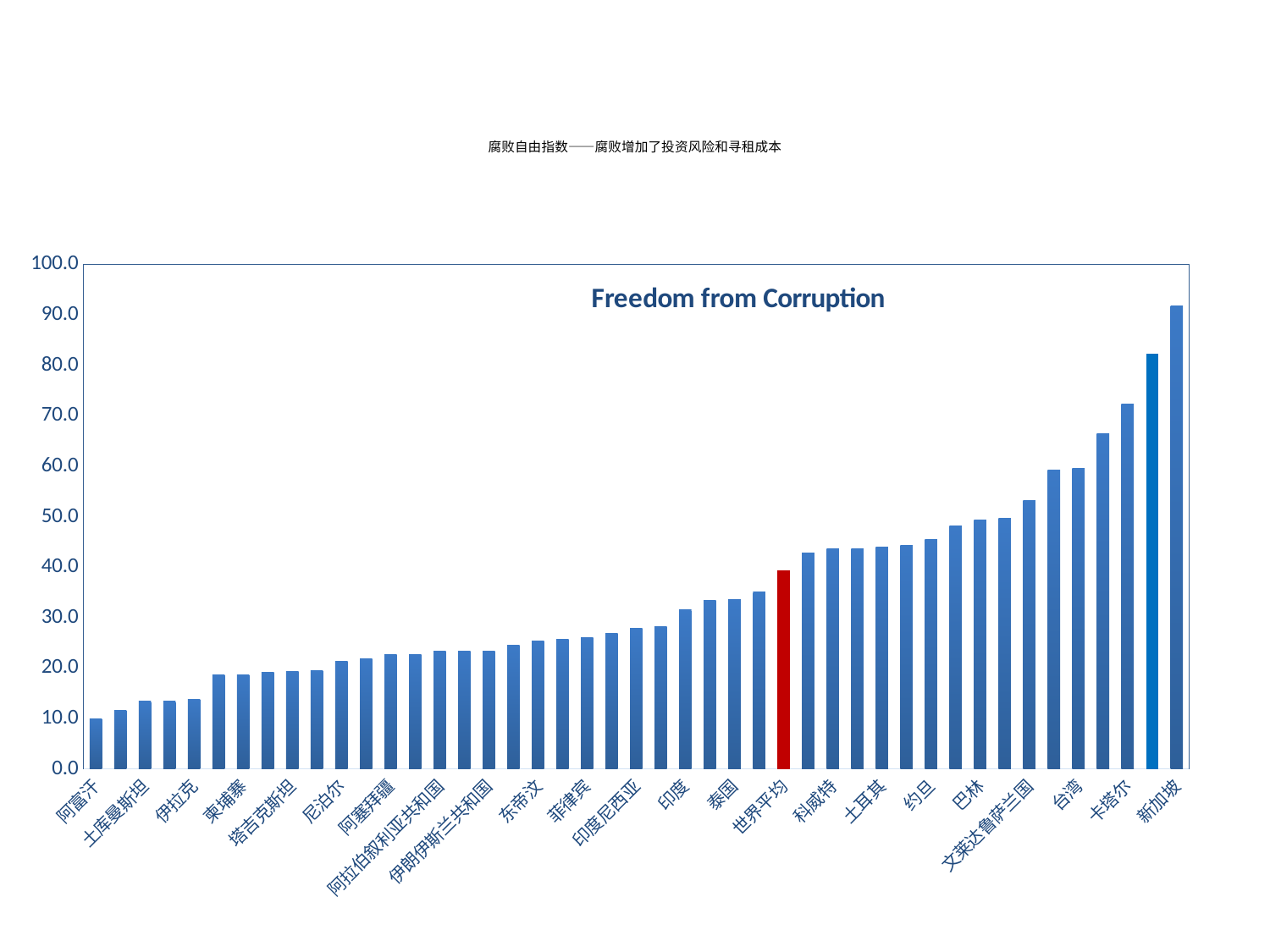
Is the value for 卡塔尔 greater or less than 70? greater Which category has the lowest Freedom from Corruption value? 阿富汗 Is the value for 伊拉克 greater or less than 20? less Which has a larger value, 台湾 or 泰国? 台湾 Which category is drawn with a red bar? 世界平均 What kind of chart is shown on the slide? bar chart Is the value for 世界平均 greater or less than 30? greater Which category has the highest Freedom from Corruption value? 新加坡 Do the values rise or fall moving from left to right along the x axis? rise